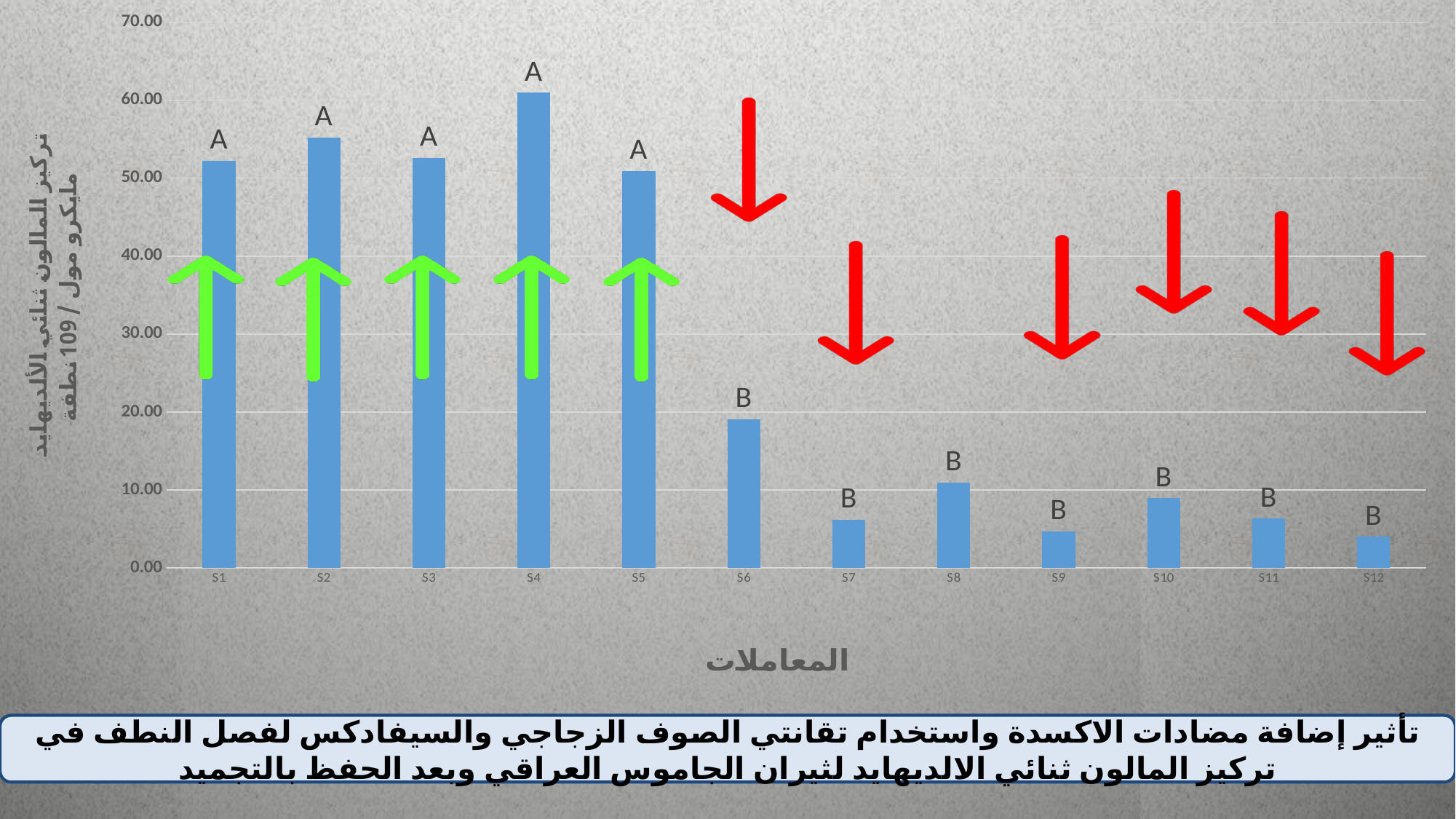
Is the value for S1 greater or less than 40? greater Is the value for S6 greater or less than 30? less What kind of chart is shown on the slide? bar chart Which category has the highest bar? S4 Which is larger, the value for S6 or the value for S7? S6 Is the value for S9 greater or less than 10? less What letter is printed above the bar for S6? B Are the bars for S6 through S12 generally higher or lower than the bars for S1 through S5? lower How many categories (treatments) are plotted on the x axis? 12 Which is larger, the value for S8 or the value for S9? S8 Which is larger, the value for S4 or the value for S6? S4